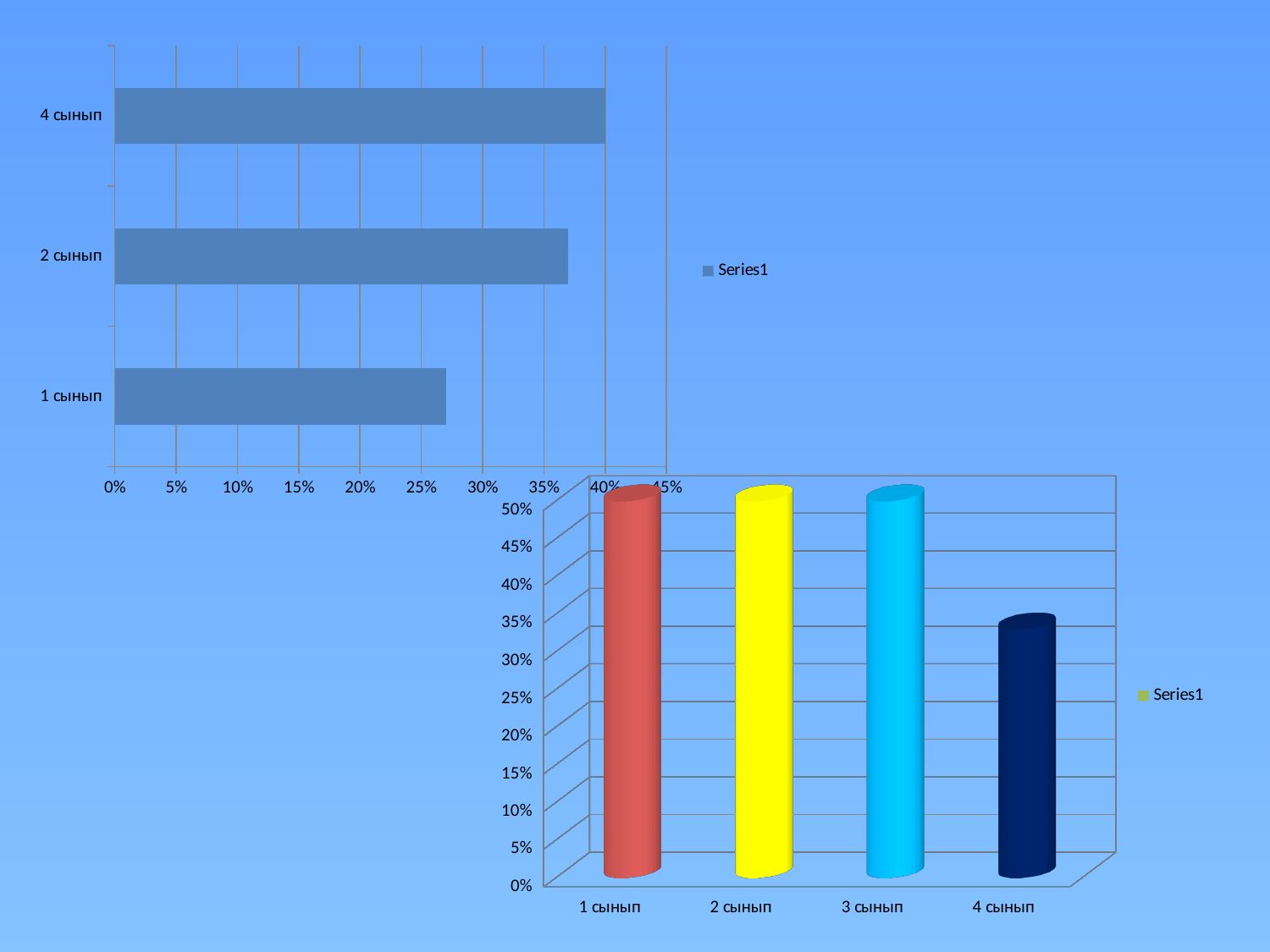
How many categories are shown in the bottom-right chart? 4 In the top-left chart, is the value for 1 сынып greater or less than 25%? greater In the top-left chart, is the value for 1 сынып greater or less than 30%? less In the bottom-right chart, is the value for 1 сынып greater or less than 45%? greater What kind of chart is the bottom-right chart? bar chart In the bottom-right chart, which category has the lowest value? 4 сынып In the top-left chart, which category has the shortest bar? 1 сынып In the top-left chart, which category has the longest bar? 4 сынып How many categories are shown in the top-left chart? 3 In the top-left chart, which is larger, the value for 2 сынып or the value for 1 сынып? 2 сынып